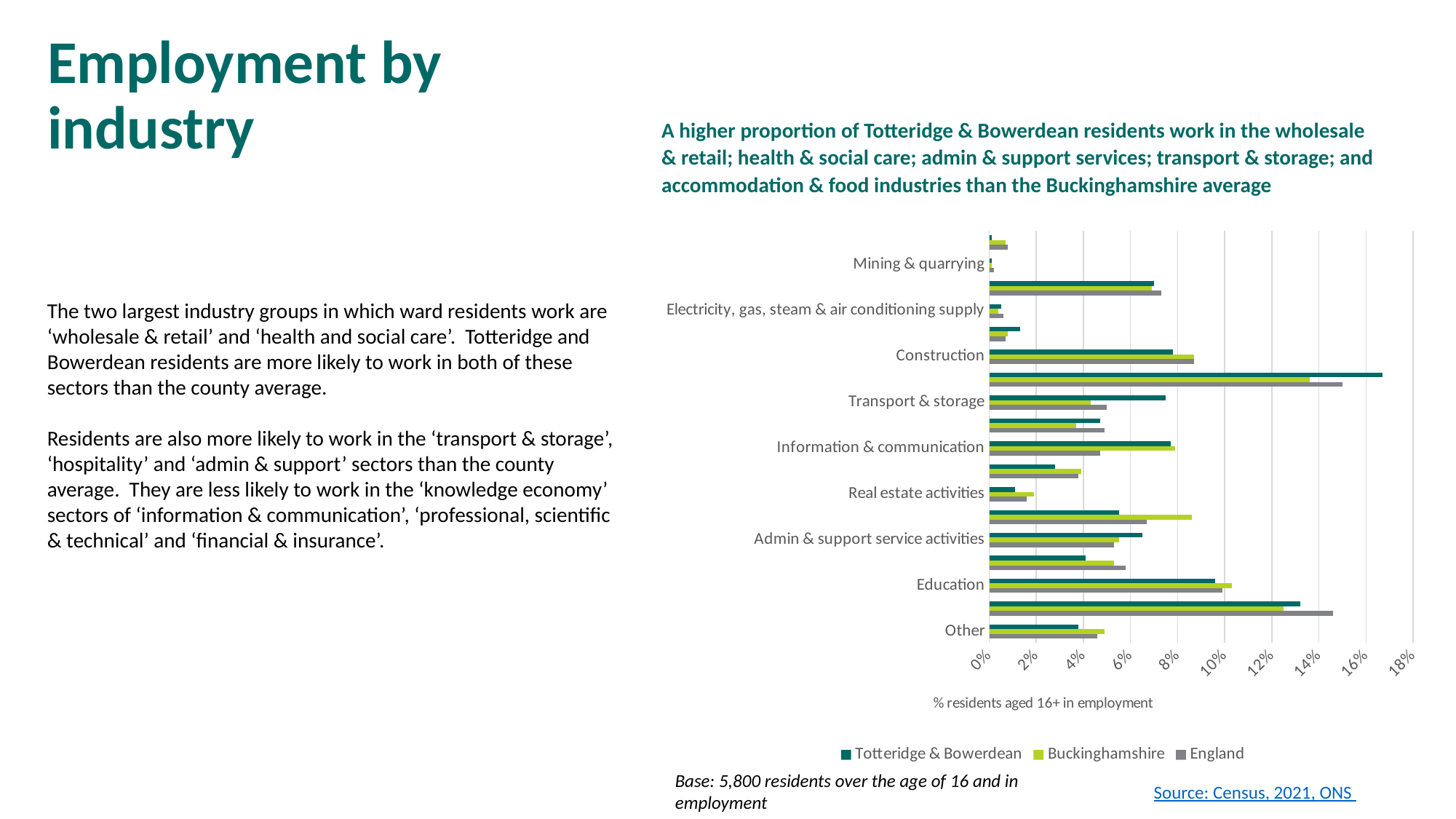
Is the England value for Information & communication greater or less than 6%? less Is the Totteridge & Bowerdean value for Transport & storage greater or less than 6%? greater How many series does the chart legend list? 3 For Transport & storage, which is larger: the Totteridge & Bowerdean value or the Buckinghamshire value? Totteridge & Bowerdean What kind of chart is shown on the slide? bar chart What is the label on the chart's horizontal axis? % residents aged 16+ in employment For Real estate activities, which is larger: the Totteridge & Bowerdean value or the Buckinghamshire value? Buckinghamshire What are the three series named in the chart legend? Totteridge & Bowerdean, Buckinghamshire, England Is the Totteridge & Bowerdean value for Real estate activities greater or less than 2%? less For Information & communication, which is larger: the Buckinghamshire value or the England value? Buckinghamshire